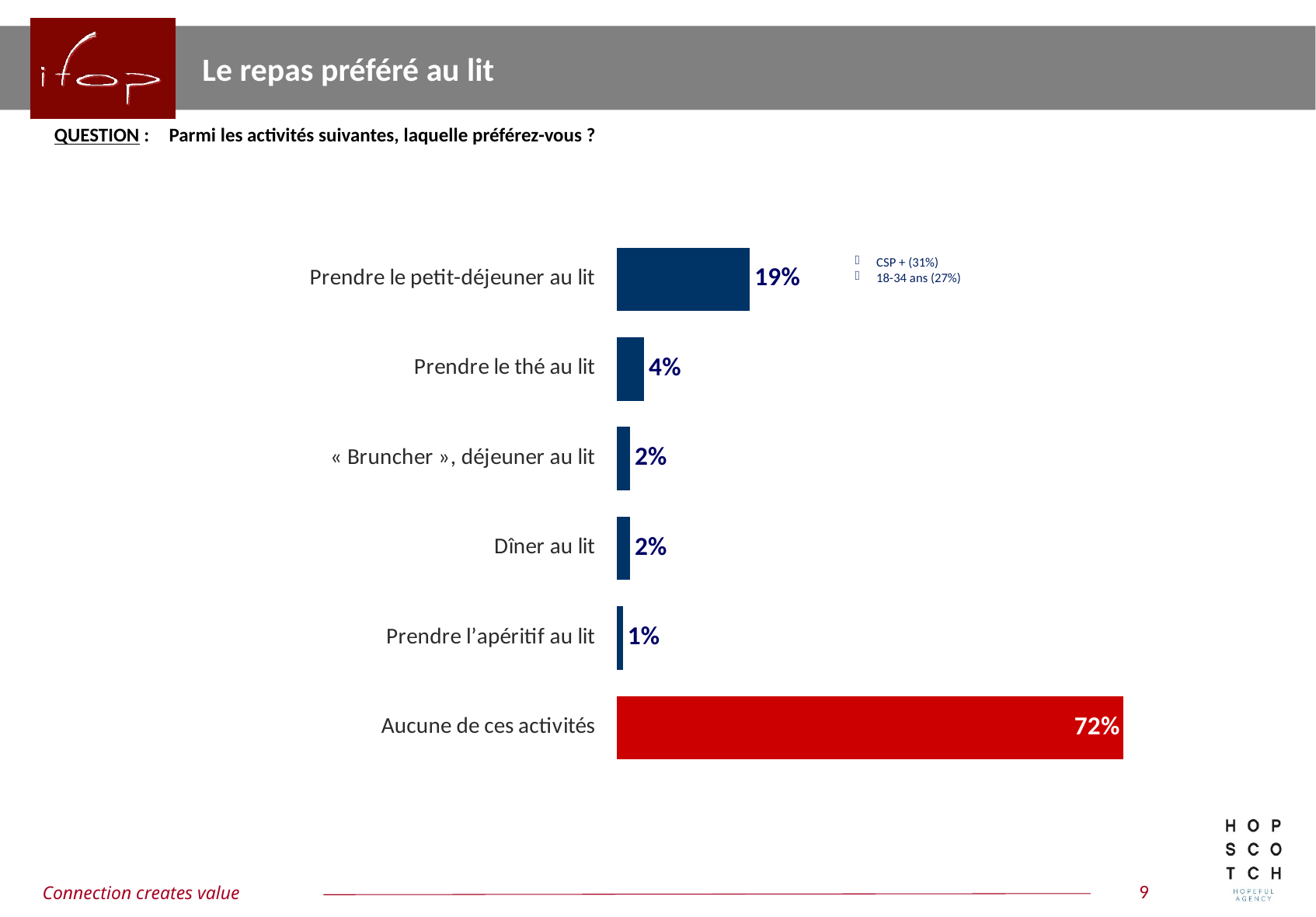
What percentage of respondents prefer "Prendre le petit-déjeuner au lit"? 19% What percentage is shown for "Prendre le thé au lit"? 4% What is the difference between "Aucune de ces activités" and "Prendre le petit-déjeuner au lit"? 53% Which is larger, the value for "Prendre le thé au lit" or for "Dîner au lit"? Prendre le thé au lit What is the title of the slide? Le repas préféré au lit Which category has the lowest value? Prendre l'apéritif au lit What is the value shown for "Aucune de ces activités"? 72% What is the value for "Prendre l'apéritif au lit"? 1% Which category has the highest value? Aucune de ces activités What type of chart is shown on the slide? Bar chart Which bar is coloured red rather than dark blue? Aucune de ces activités How many categories are shown in the chart? 6